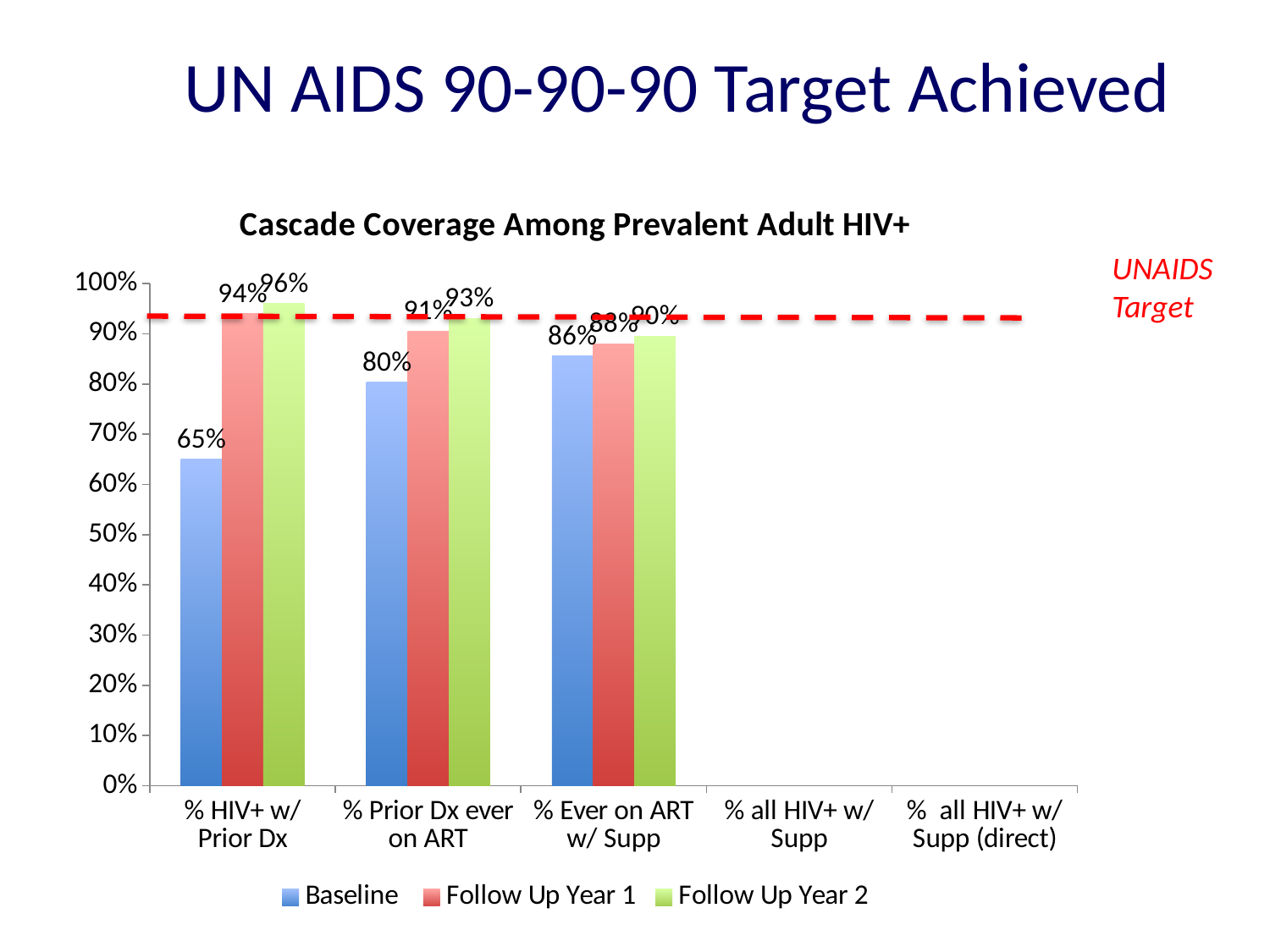
Which category has the lowest Baseline value? % HIV+ w/ Prior Dx What is the difference between the Follow Up Year 2 and Baseline values for % HIV+ w/ Prior Dx? 31 percentage points How many series does the legend list? 3 Which has the larger Baseline value: % Prior Dx ever on ART or % Ever on ART w/ Supp? % Ever on ART w/ Supp For % Prior Dx ever on ART, do the values rise or fall from Baseline to Follow Up Year 2? rise What is the Baseline value for % Ever on ART w/ Supp? 86% What kind of chart is shown on the slide? bar chart What is the Follow Up Year 2 value for % HIV+ w/ Prior Dx? 96% What is the title of the chart? Cascade Coverage Among Prevalent Adult HIV+ Is the Baseline value for % HIV+ w/ Prior Dx greater or less than 70%? less What is the Baseline value for % HIV+ w/ Prior Dx? 65% What is the Follow Up Year 1 value for % Prior Dx ever on ART? 91%